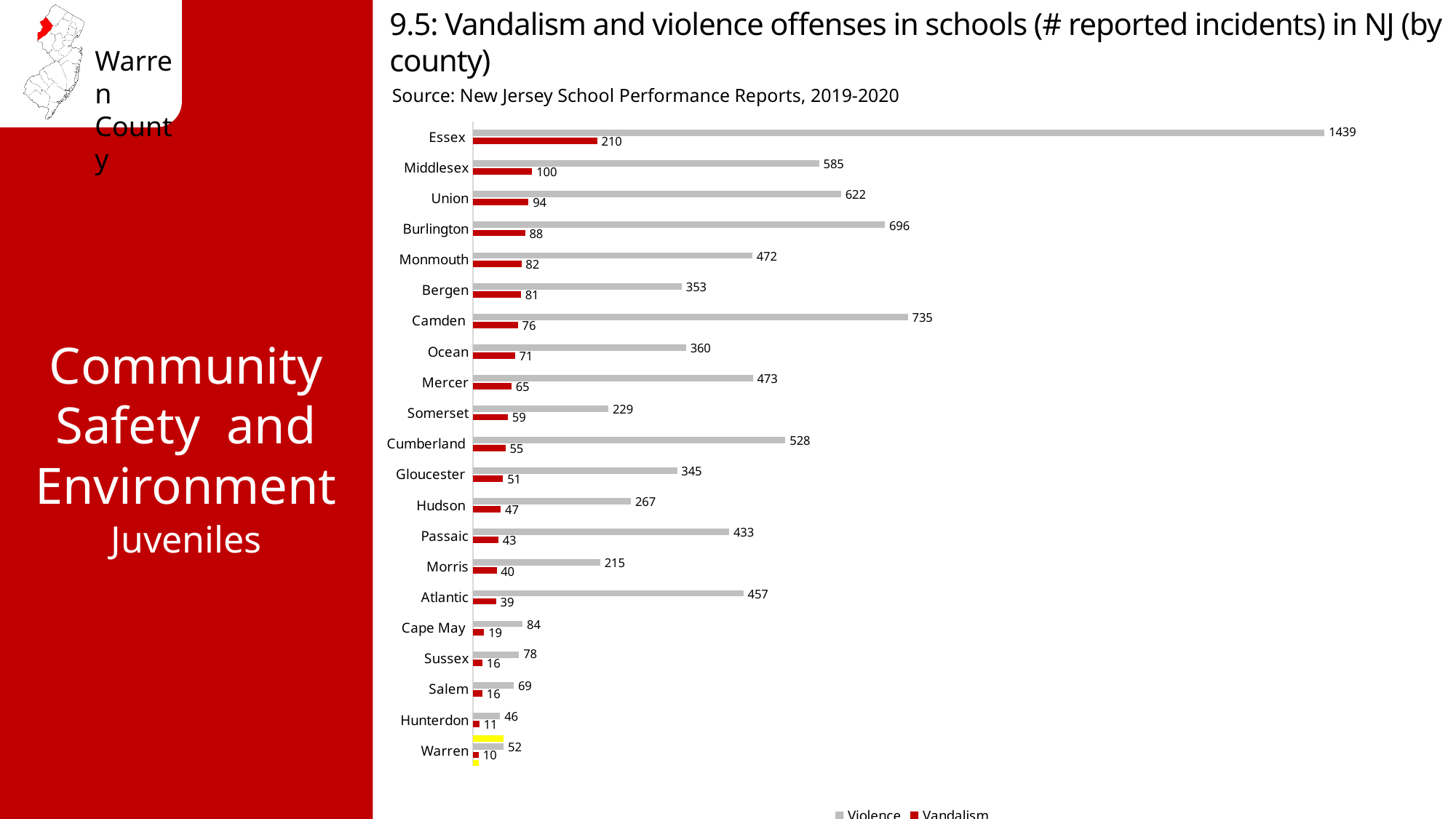
What is the difference between the violence incidents in Essex and Middlesex? 854 What is the difference between violence and vandalism incidents in Warren County? 42 Which county has the highest number of reported violence incidents? Essex Which county has the lowest number of reported vandalism incidents? Warren Which series is shown in red in the chart? Vandalism Which county has more reported violence incidents, Union or Burlington? Burlington How many series does the legend list? 2 What kind of chart is shown on the slide? Bar chart What is the number of reported vandalism incidents in schools for Warren County? 10 How many counties are shown in the chart? 21 What is the number of reported violence incidents in schools for Camden County? 735 What is the number of reported violence incidents in schools for Essex County? 1439